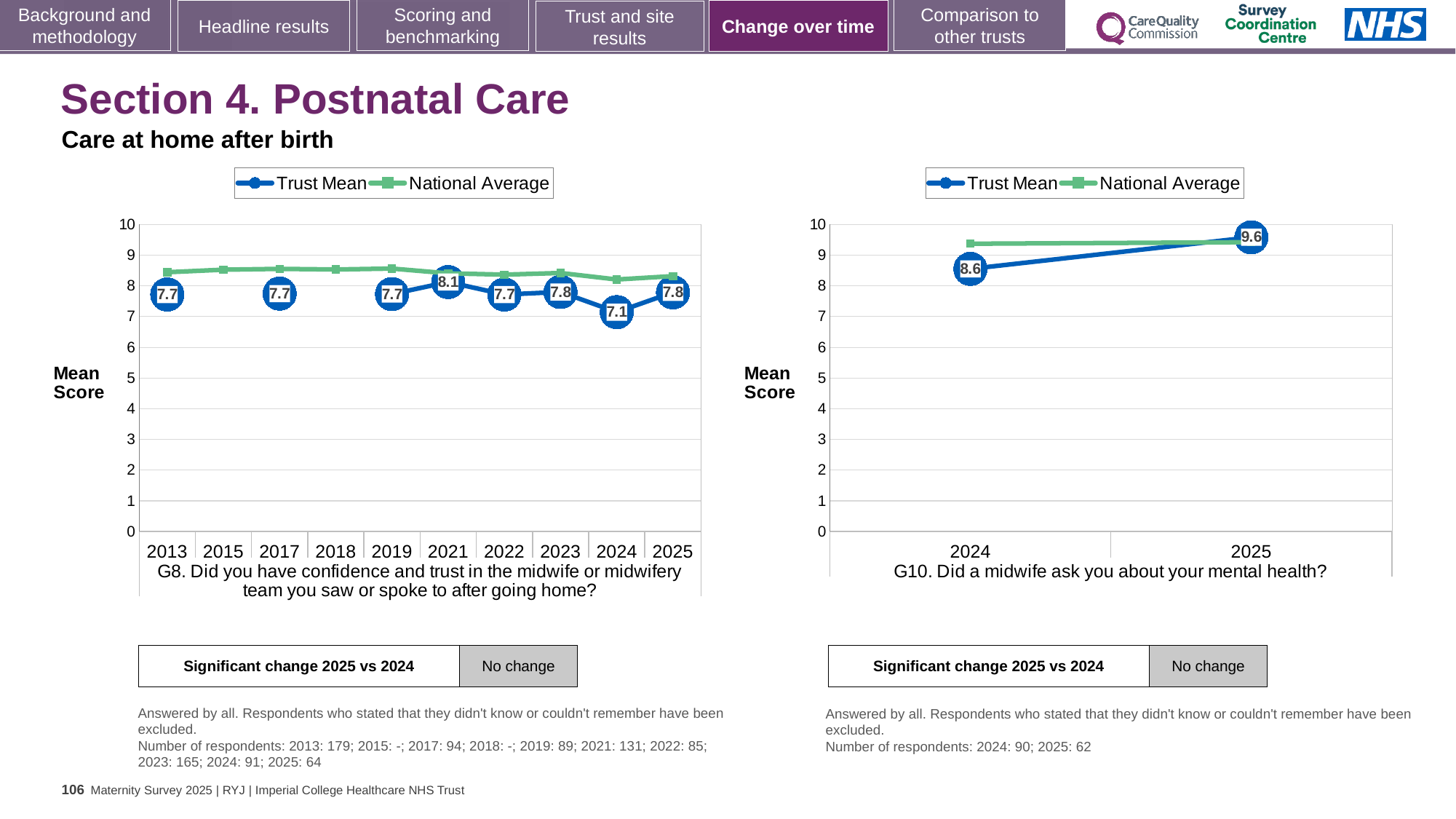
In the right chart (G10), does the Trust Mean rise or fall from 2024 to 2025? rise In the left chart (G8), how many years are shown on the x axis? 10 In the left chart (G8), what is the Trust Mean for 2024? 7.1 In the left chart (G8), what is the Trust Mean for 2021? 8.1 How many series does the legend of the left chart (G8) list? 2 In the left chart (G8), which year has the highest Trust Mean? 2021 In the left chart (G8), what is the difference between the Trust Mean for 2025 and for 2024? 0.7 In the right chart (G10), what is the Trust Mean for 2025? 9.6 In the left chart (G8), which year has the lowest Trust Mean? 2024 In the right chart (G10), by how much did the Trust Mean change from 2024 to 2025? 1.0 In the right chart (G10), what is the Trust Mean for 2024? 8.6 In the left chart (G8), is the National Average for 2013 greater or less than 8? greater